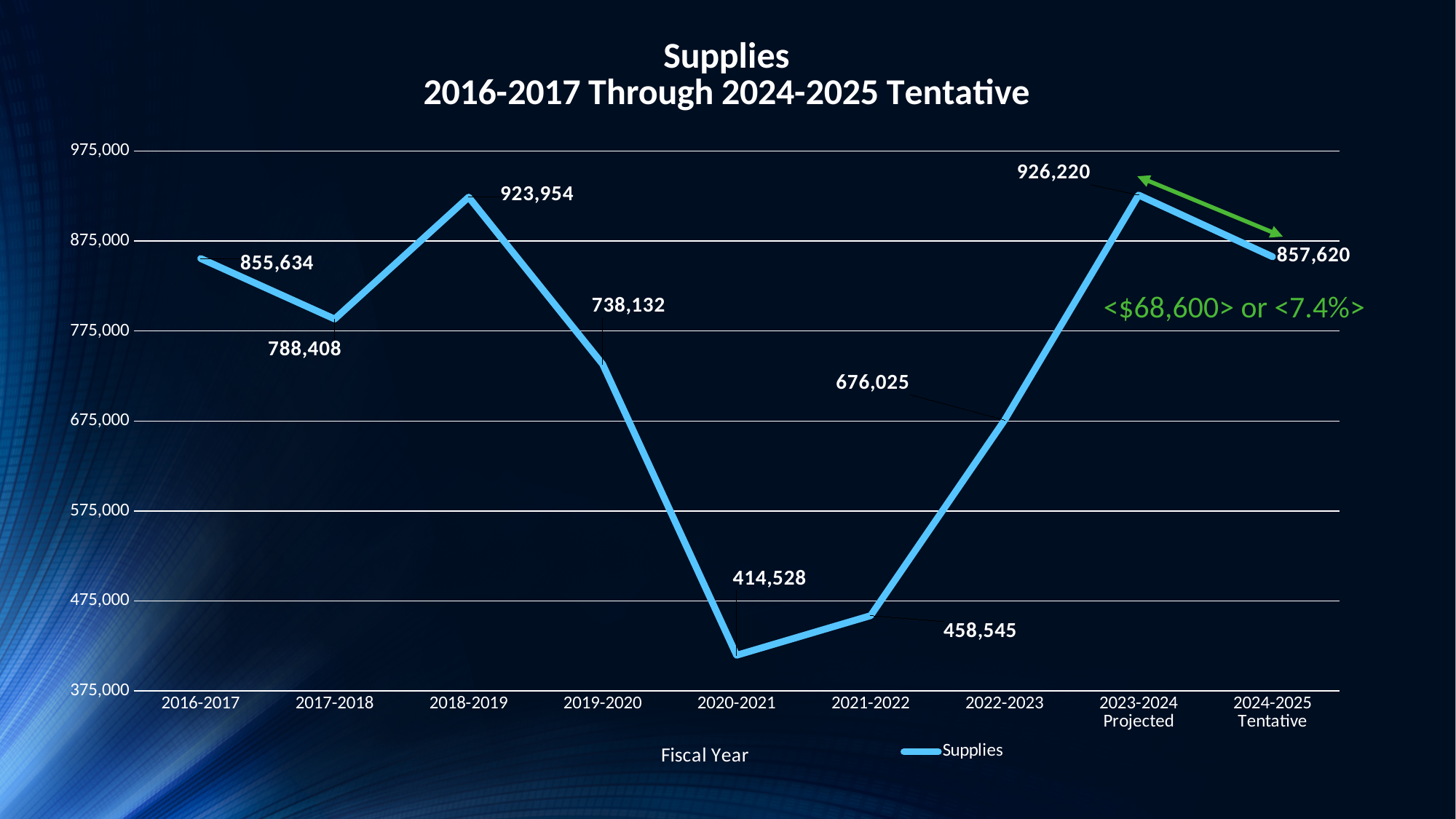
What kind of chart is shown on the slide? Line chart Which fiscal year has the highest Supplies value? 2023-2024 Projected Which is larger, the Supplies value for 2019-2020 or for 2022-2023? 2019-2020 What is the Supplies value for 2023-2024 Projected? 926,220 Which fiscal year has the lowest Supplies value? 2020-2021 How many fiscal years are plotted on the chart? 9 What is the Supplies value for 2020-2021? 414,528 What is the Supplies value for 2017-2018? 788,408 Does the Supplies value rise or fall from 2021-2022 to 2023-2024 Projected? Rise What is the difference between the Supplies values for 2016-2017 and 2017-2018? 67,226 What is the difference between the Supplies values for 2023-2024 Projected and 2024-2025 Tentative? 68,600 What is the Supplies value for 2024-2025 Tentative? 857,620